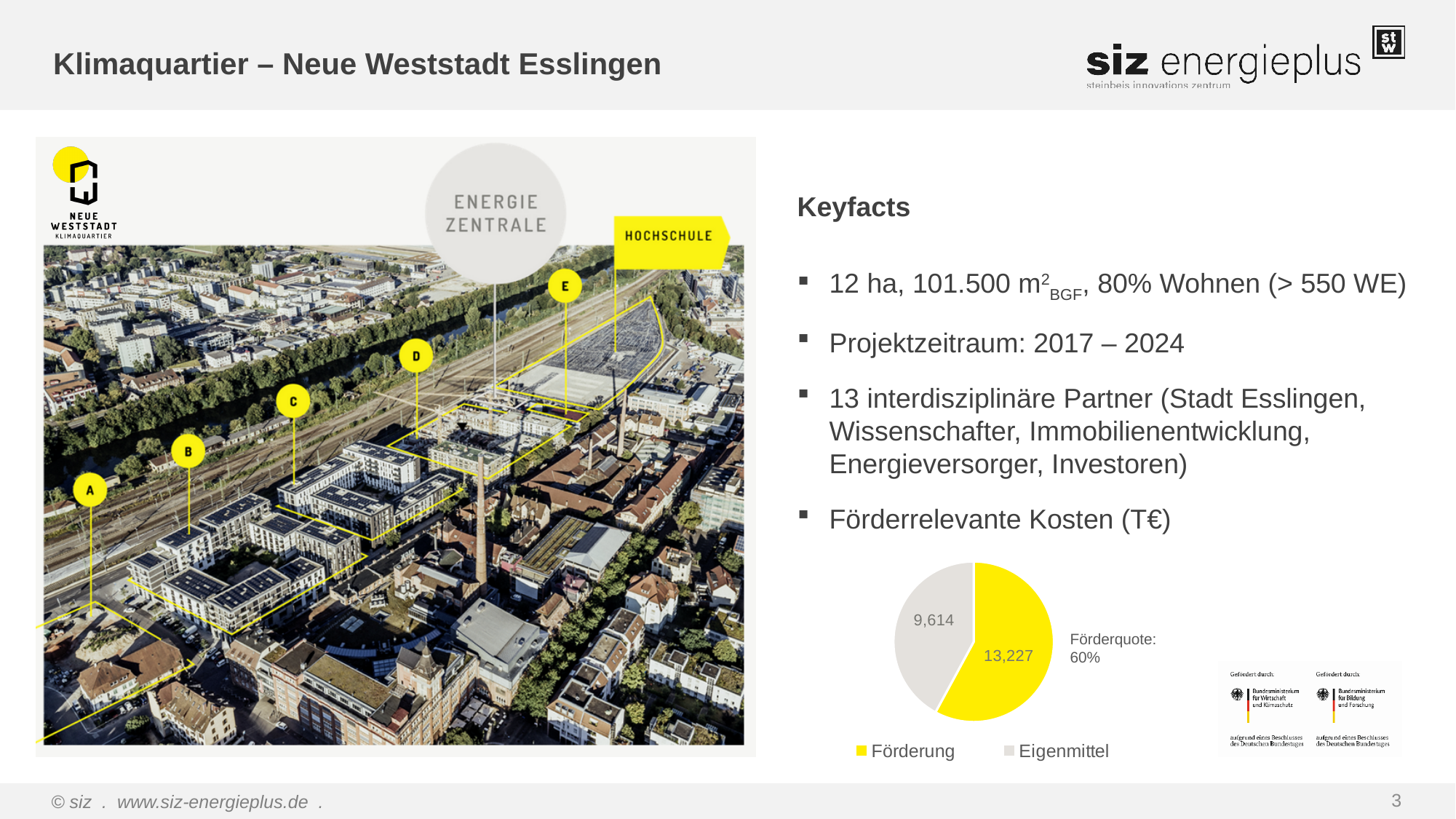
What colour is the Förderung slice in the pie chart? yellow What is the difference between the Förderung and Eigenmittel values in the pie chart? 3,613 What Förderquote is stated next to the pie chart? 60% Which is larger in the pie chart, Förderung or Eigenmittel? Förderung How many slices does the pie chart have? 2 Which slice of the pie chart is the largest? Förderung What is the value of the Förderung slice in the pie chart? 13,227 Which slice of the pie chart is the smallest? Eigenmittel What kind of chart is shown under "Förderrelevante Kosten (T€)"? pie chart How many entries does the legend of the pie chart list? 2 What is the value of the Eigenmittel slice in the pie chart? 9,614 What is the total of the two slices in the pie chart? 22,841